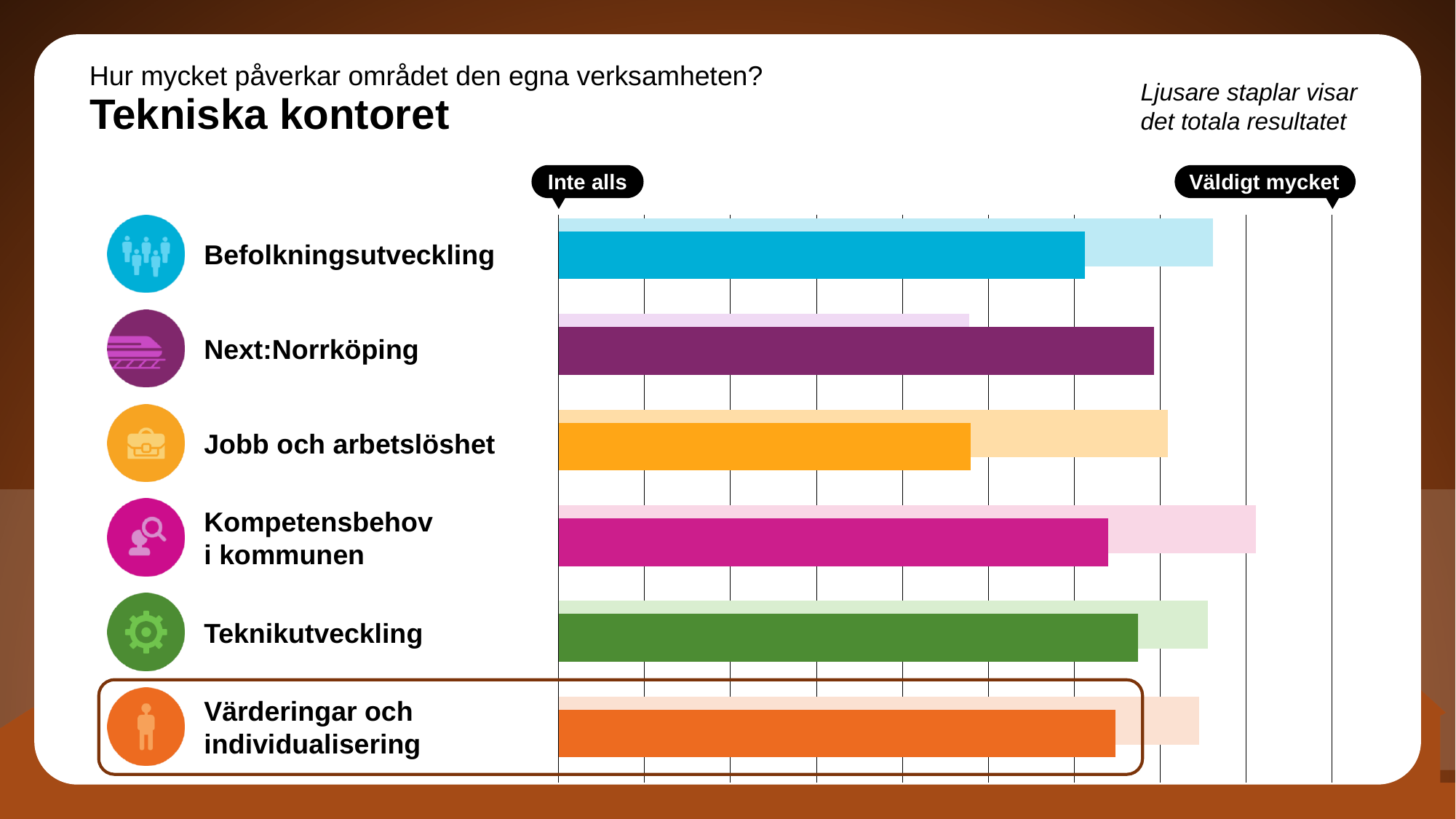
Which dark bar is longer: Värderingar och individualisering or Jobb och arbetslöshet? Värderingar och individualisering Which category has the shortest dark bar (Tekniska kontoret result)? Jobb och arbetslöshet According to the note on the slide, what do the lighter bars show? det totala resultatet Which dark bar is longer: Next:Norrköping or Jobb och arbetslöshet? Next:Norrköping What kind of chart is shown on the slide? bar chart Which light bar is longer: Befolkningsutveckling or Next:Norrköping? Befolkningsutveckling Which category has the longest light bar (total result)? Kompetensbehov i kommunen How many categories are plotted in the chart? 6 What label marks the left end of the chart's axis? Inte alls Which category has the shortest light bar (total result)? Next:Norrköping